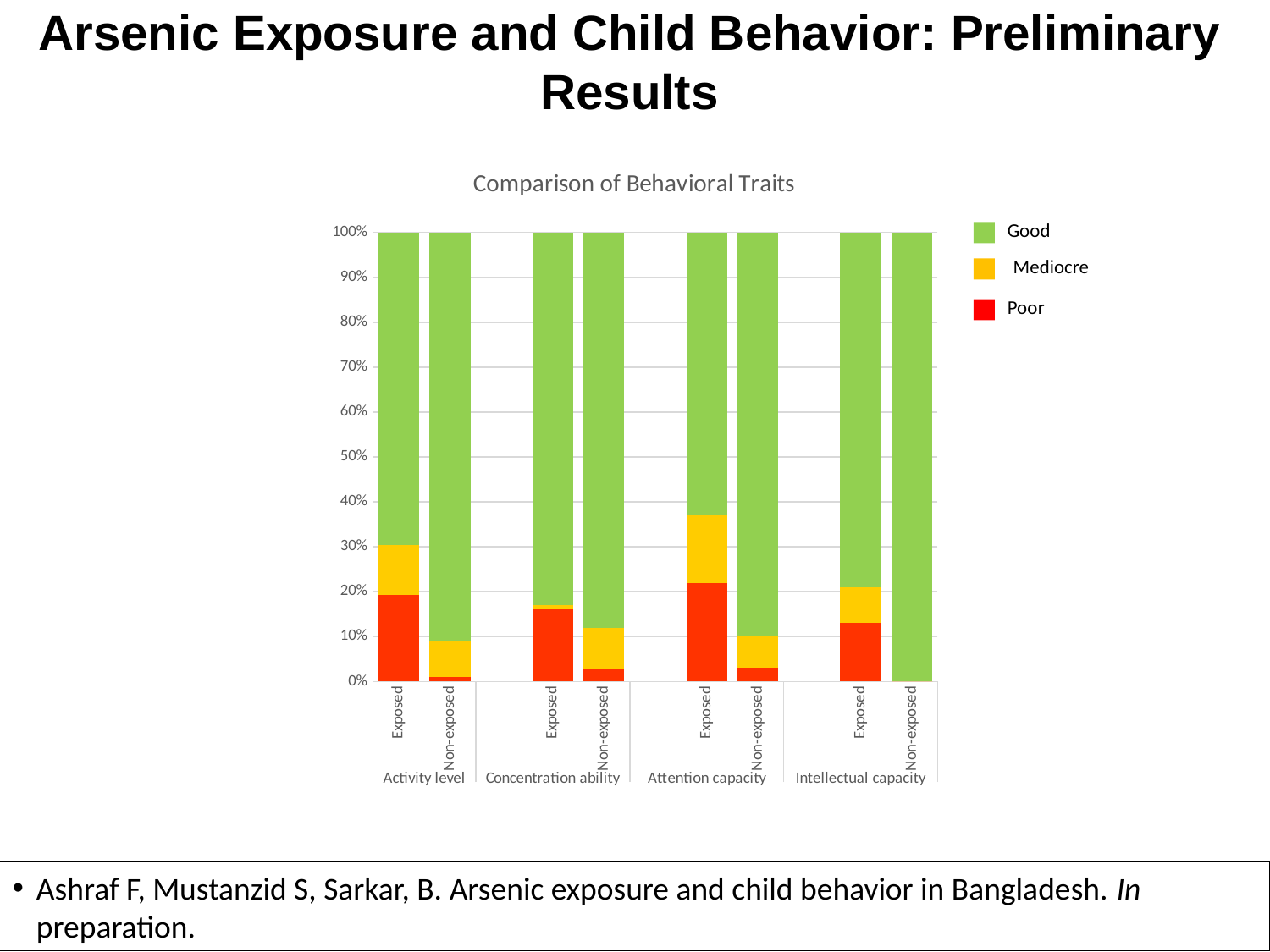
What kind of chart is shown on the slide? Stacked bar chart How many behavioral trait categories are shown on the x axis? 4 Is the Good share for the Exposed group in Attention capacity greater or less than 70%? less How many bars are plotted in the chart? 8 Is the Poor share for the Exposed group in Activity level greater or less than 10%? greater Among the Non-exposed bars, which category has the smallest Poor share? Intellectual capacity How many series does the chart legend list? 3 Is the Good share for the Non-exposed group in Intellectual capacity greater or less than 90%? greater Which colour represents the 'Poor' series in the chart? Red In Concentration ability, which group has the larger Poor share, Exposed or Non-exposed? Exposed What is the title of the chart? Comparison of Behavioral Traits